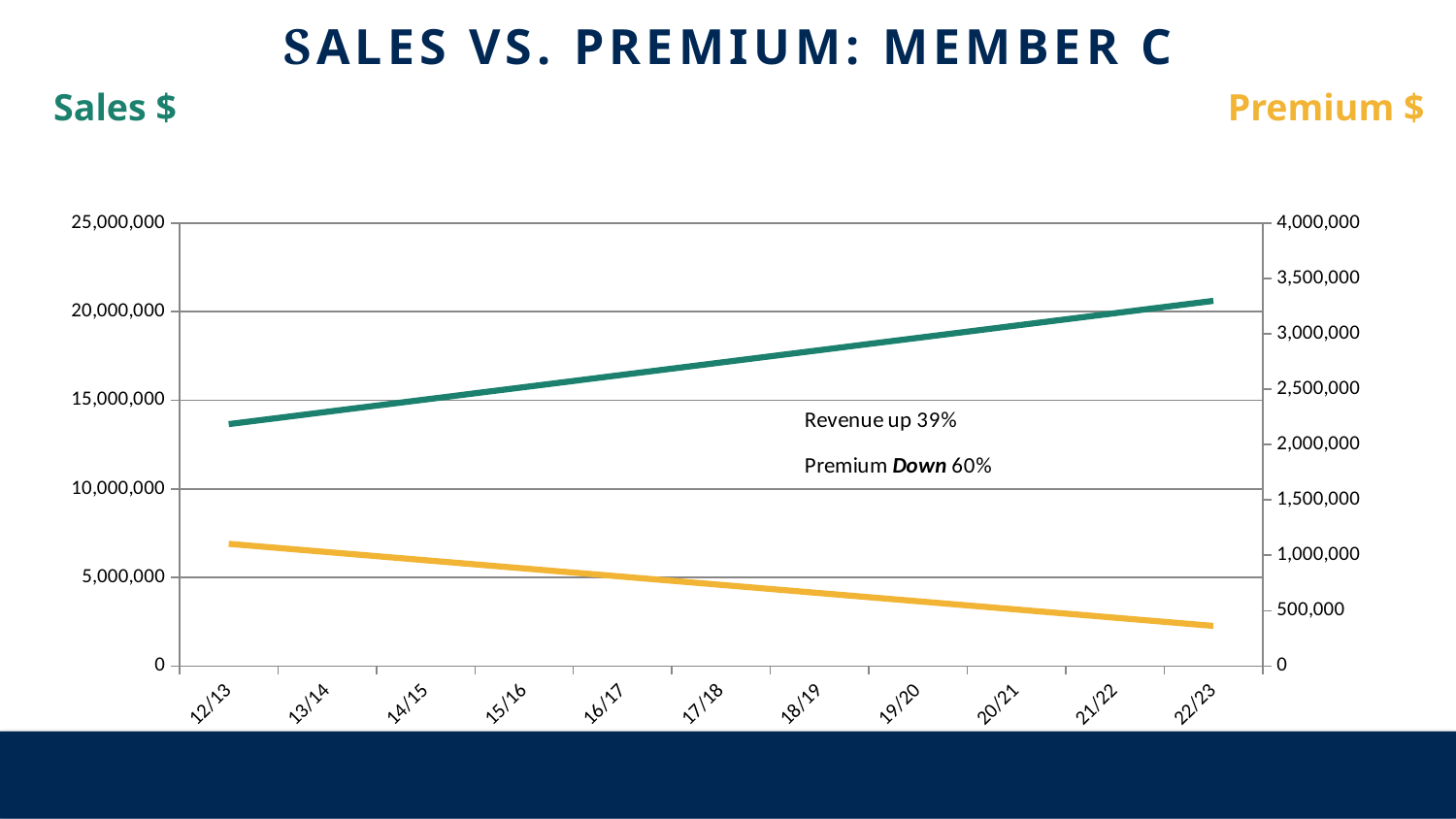
Is the Premium $ value for 12/13 greater or less than 500,000? greater Is the Premium $ value for 22/23 greater or less than 500,000? less How many fiscal-year categories are shown on the x axis? 11 Which colour is used for the Premium $ line? Yellow How many lines are plotted on the chart? 2 What is the title of the chart? SALES VS. PREMIUM: MEMBER C According to the annotation on the chart, by what percentage is revenue up? 39% What kind of chart is shown on the slide? Line chart Does the Sales $ line rise or fall from 12/13 to 22/23? Rise Does the Premium $ line rise or fall from 12/13 to 22/23? Fall Is the Sales $ value for 22/23 greater or less than 15,000,000? greater